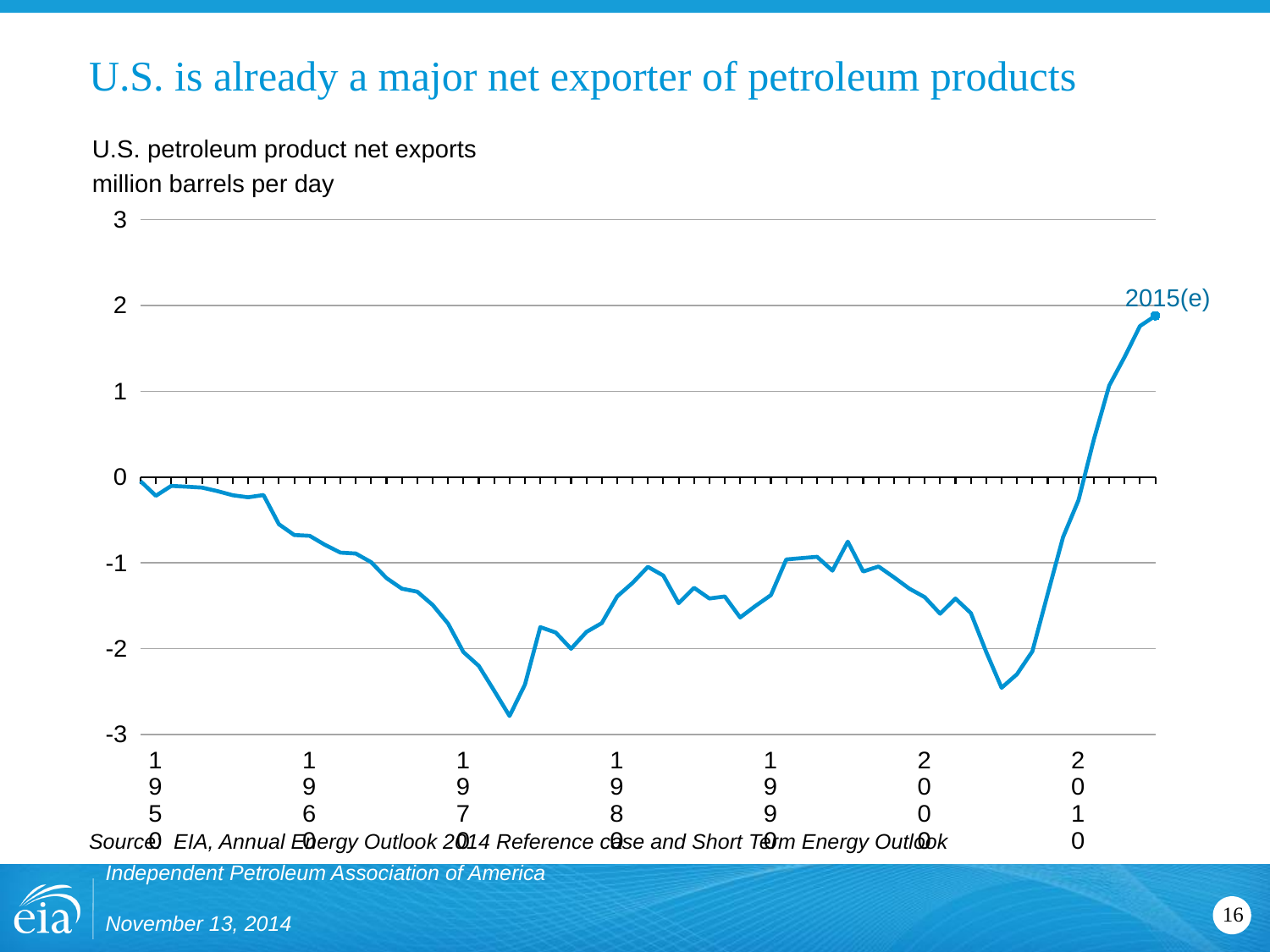
Is the lowest value on the chart greater or less than -2? less What unit is the chart's y axis measured in? million barrels per day Which is larger, the value for 2015(e) or the value for 2000? 2015(e) Do the values rise or fall between 1950 and 1960? fall Do the values rise or fall between 2010 and 2015(e)? rise Is the value for 1970 greater or less than -1? less Is the value for 2015(e) greater or less than 1? greater Which is larger, the value for 1960 or the value for 1970? 1960 What kind of chart is shown on the slide? line chart What is the title of the chart? U.S. petroleum product net exports